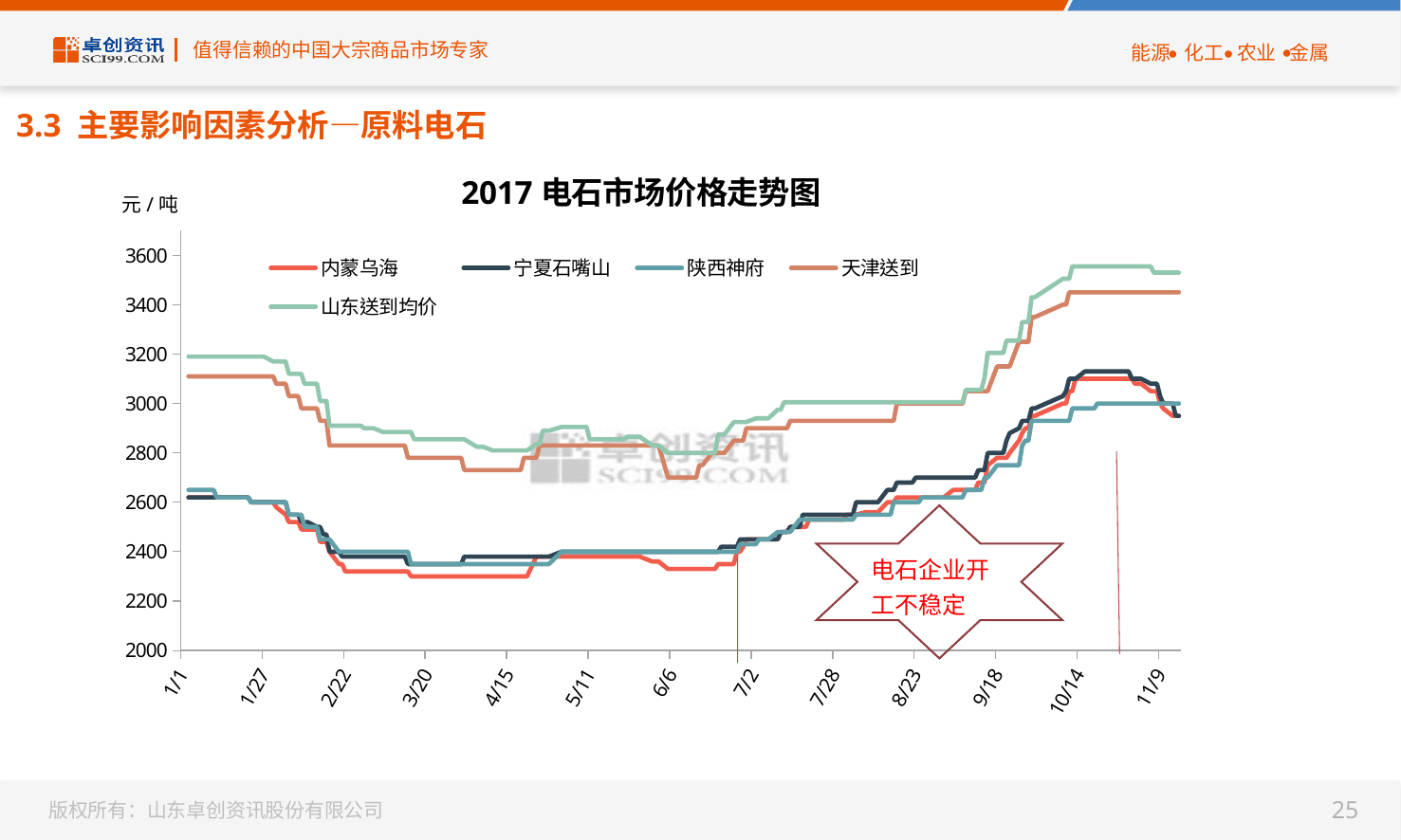
At 1/1, which is higher: 山东送到均价 or 陕西神府? 山东送到均价 Does the 山东送到均价 line rise or fall between 7/28 and 10/14? rise What unit is shown for the y axis of the chart? 元/吨 How many series does the legend of the chart list? 5 Does the 内蒙乌海 line rise or fall between 1/1 and 2/22? fall Is the value for 内蒙乌海 at 3/20 greater or less than 2400? less What kind of chart is shown on the slide? line chart Is the value for 山东送到均价 at 1/1 greater or less than 3000? greater Is the value for 天津送到 at 11/9 greater or less than 3400? greater What is the title of the chart? 2017 电石市场价格走势图 Which series has the highest value at the end of the chart (11/9)? 山东送到均价